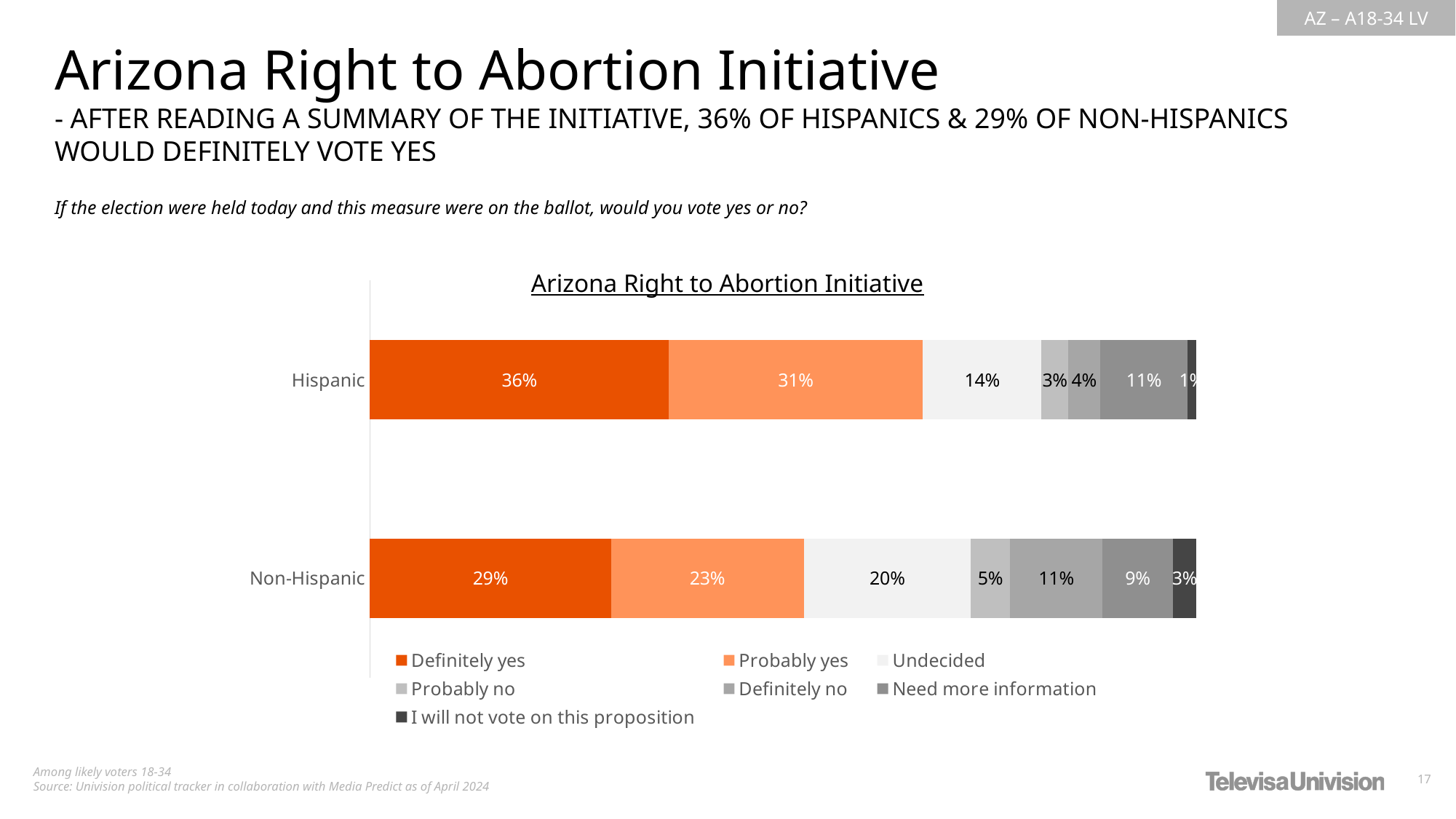
Which response category has the lowest value for Non-Hispanic respondents? I will not vote on this proposition Which response category has the highest value for Hispanic respondents? Definitely yes What is the difference between the 'Definitely yes' values for Hispanic and Non-Hispanic respondents? 7% What is the 'Probably yes' value for Non-Hispanic respondents? 23% What percentage of Hispanic respondents said they need more information? 11% Which group has the larger 'Undecided' share, Hispanic or Non-Hispanic? Non-Hispanic What percentage of Hispanic respondents said they would definitely vote yes? 36% How many series does the legend list? 7 Which group has the larger 'Definitely no' share, Hispanic or Non-Hispanic? Non-Hispanic How many groups (categories) are shown on the chart? 2 What kind of chart is shown on the slide? Stacked bar chart What percentage of Non-Hispanic respondents are undecided? 20%